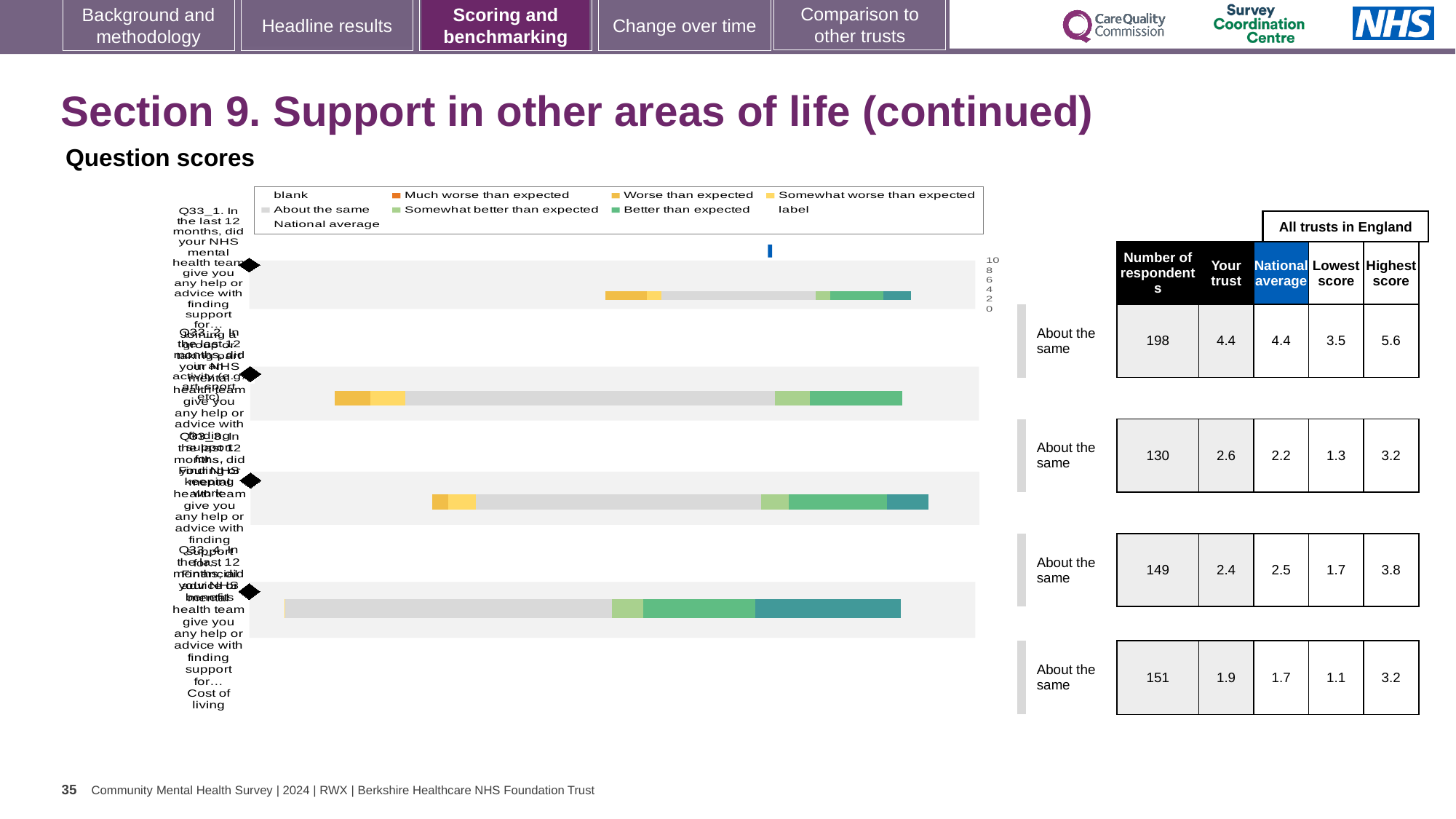
In the table beside the chart, what is the national average for the fourth question (Q33_4)? 1.7 In the table beside the chart, which question has the highest 'Your trust' score? Q33_1 In the table beside the chart, what is the difference between the highest score and the lowest score for the first question (Q33_1)? 2.1 In the table beside the chart, is 'Your trust' or the national average larger for the third question (Q33_3)? National average Which legend entry is shown in dark orange? Much worse than expected In the table beside the chart, what is the number of respondents for the first question (Q33_1)? 198 What kind of chart is shown under 'Question scores'? bar chart How many question bars are plotted in the chart? 4 In the table beside the chart, which question has the lowest number of respondents? Q33_2 What benchmark label is shown for every question in the chart? About the same In the table beside the chart, what is 'Your trust' score for the second question (Q33_2)? 2.6 What does the legend call the series drawn as a vertical marker line? National average